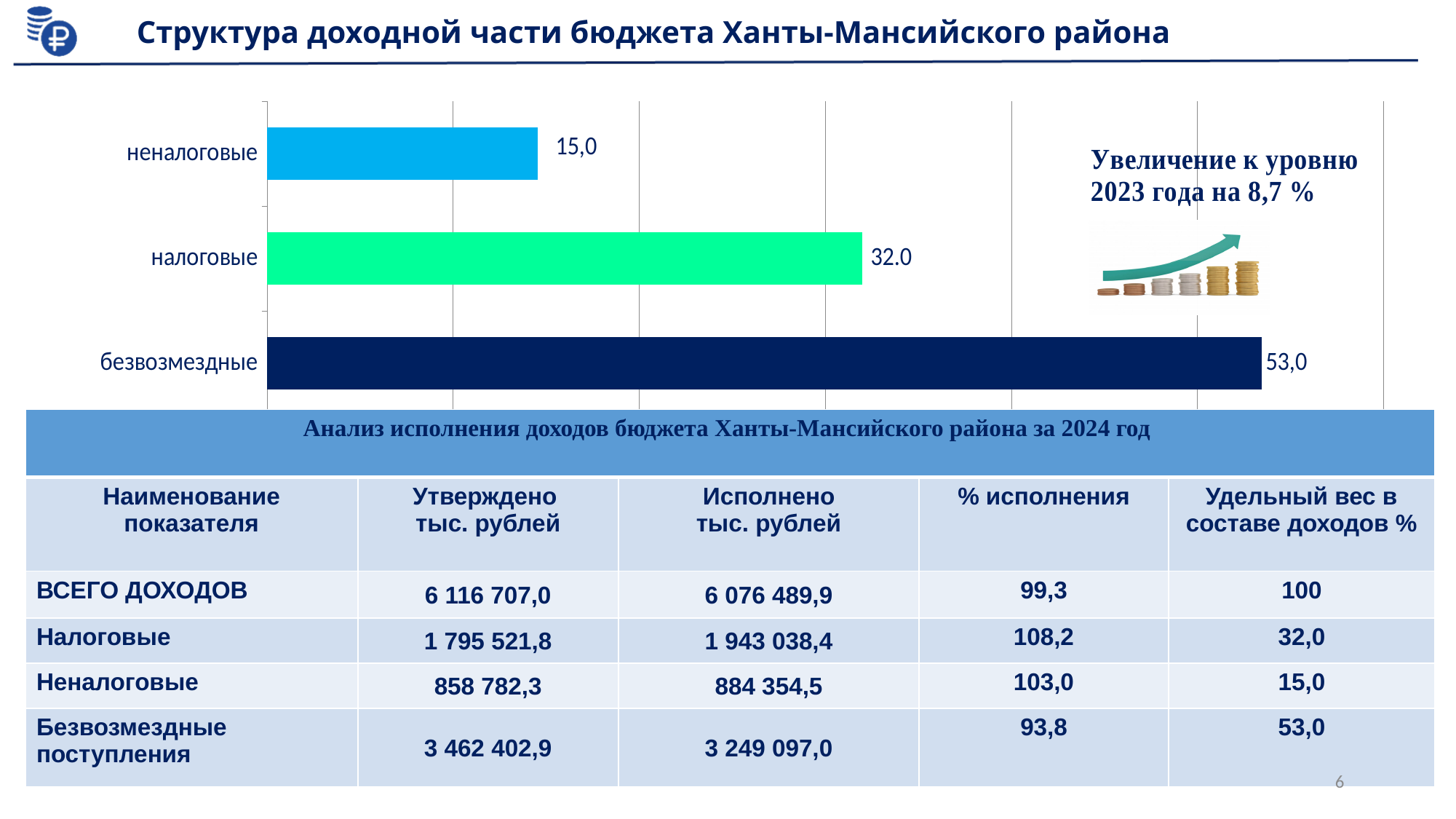
What is the total of the three values plotted in the bar chart? 100,0 What is the difference between the безвозмездные and налоговые values? 21,0 What colour is the безвозмездные bar? dark navy blue What is the difference between the налоговые and неналоговые values? 17,0 What type of chart is shown on the slide? bar chart Which category has the highest value in the bar chart? безвозмездные How many categories are plotted in the bar chart? 3 Which is larger, the value for налоговые or the value for неналоговые? налоговые What value is shown for the безвозмездные bar? 53,0 What value is shown for the неналоговые bar? 15,0 What value is shown for the налоговые bar? 32.0 Which category has the lowest value in the bar chart? неналоговые